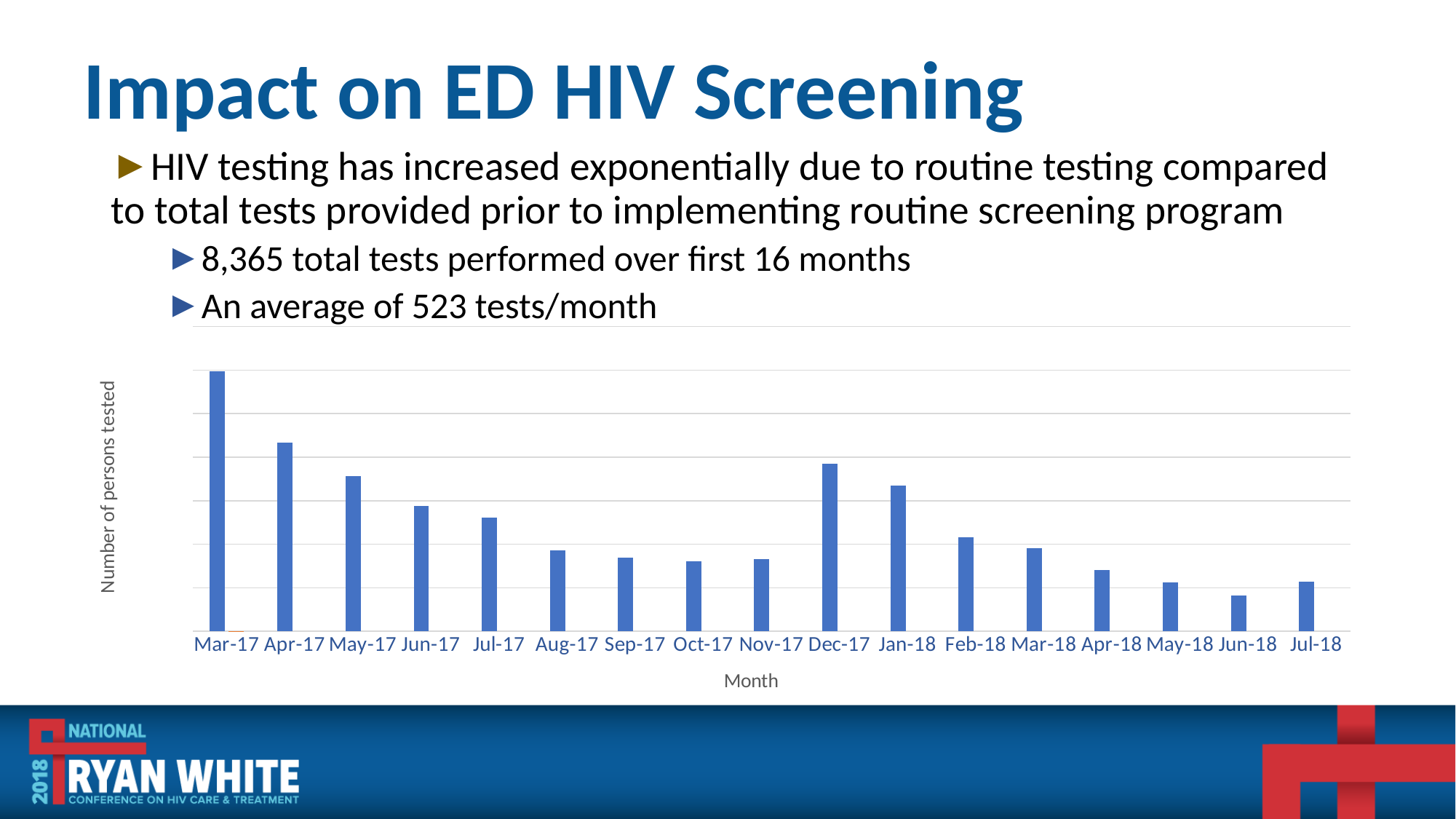
Which month has a higher number of persons tested, Mar-17 or Dec-17? Mar-17 Which month has the lowest number of persons tested? Jun-18 Do the values rise or fall from Mar-17 to Nov-17? fall What is the title of the vertical axis of the chart? Number of persons tested What is the title of the horizontal axis of the chart? Month Which month has a higher number of persons tested, Apr-18 or May-18? Apr-18 Which month has a higher number of persons tested, Apr-17 or May-17? Apr-17 What kind of chart is shown on the slide? bar chart How many months are plotted on the x axis of the chart? 17 Which month has the highest number of persons tested? Mar-17 Do the values rise or fall from Dec-17 to Jun-18? fall